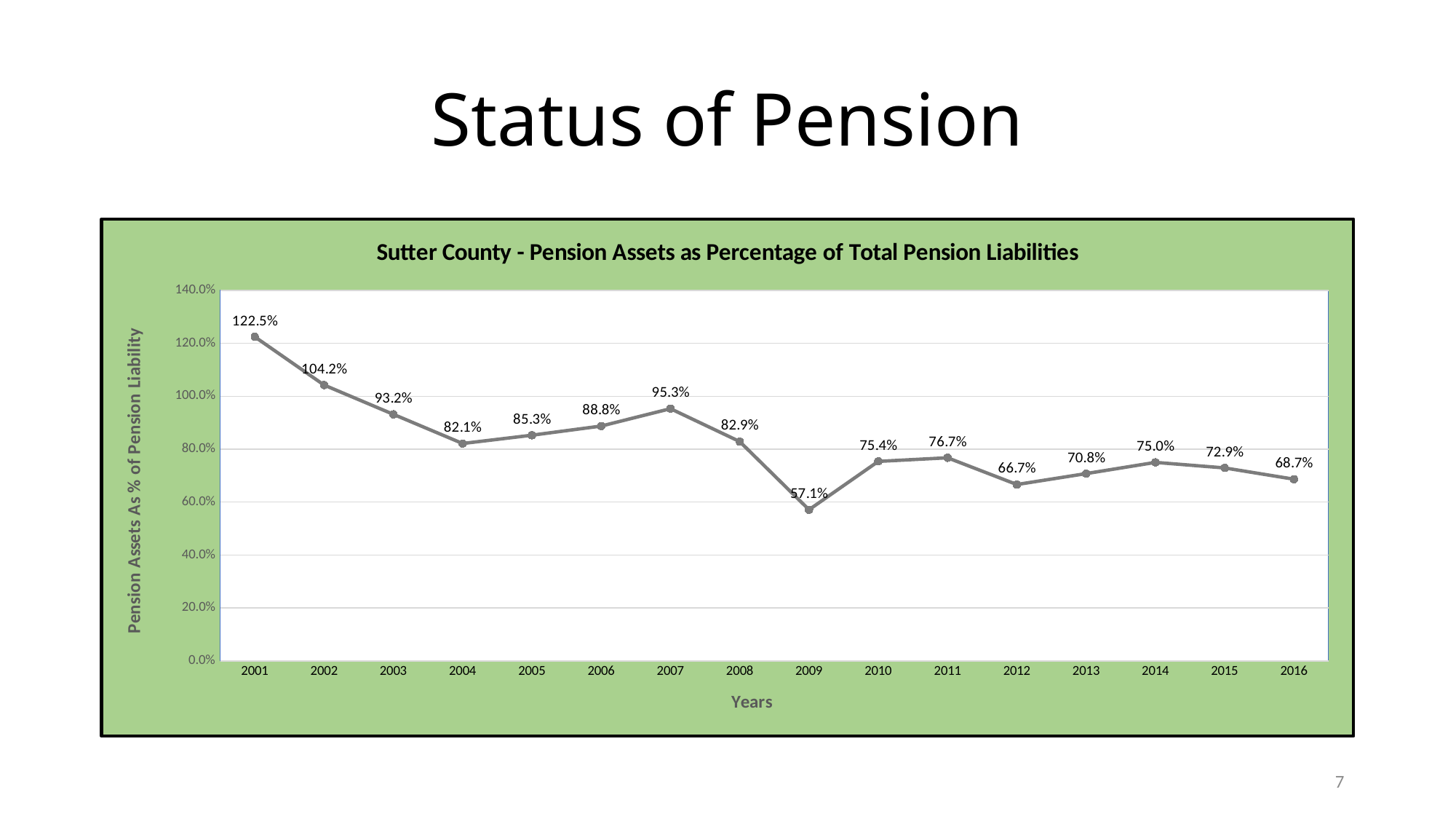
What is the title of the chart? Sutter County - Pension Assets as Percentage of Total Pension Liabilities What is the value shown for 2009? 57.1% What is the pension assets percentage for 2001? 122.5% What kind of chart is shown? line chart How many years are plotted on the x axis? 16 Which year has the lowest value? 2009 Is the value for 2003 greater or less than 100.0%? less What is the value shown for 2016? 68.7% What is the difference between the values for 2007 and 2008? 12.4% Which year has the highest value? 2001 Do the values generally rise or fall from 2001 to 2016? fall Which year has a larger value, 2011 or 2012? 2011